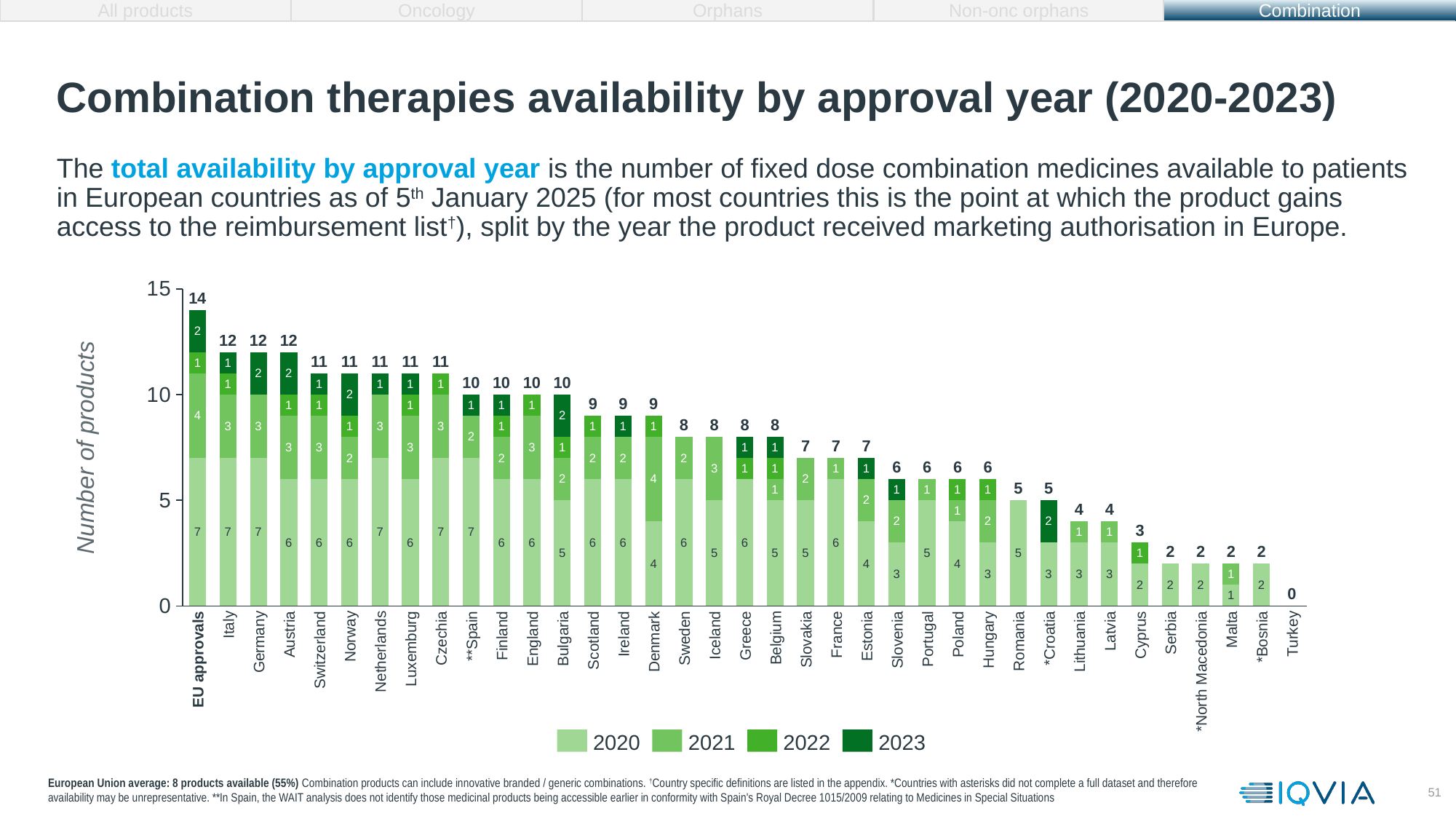
How many series does the legend list? 4 What kind of chart is shown on the slide? Stacked bar chart Which country has the lowest total number of products? Turkey What is the difference between the total for Germany and the total for Cyprus? 9 What is the total number of products for Denmark? 9 How many products approved in 2020 are available in Italy? 7 What is the label of the y axis? Number of products What is the total number of products for EU approvals? 14 Do the bar totals generally rise or fall from left to right along the x axis? Fall Which has a larger total, Sweden or Romania? Sweden How many products approved in 2023 are available in Bulgaria? 2 Which bar has the highest total number of products? EU approvals